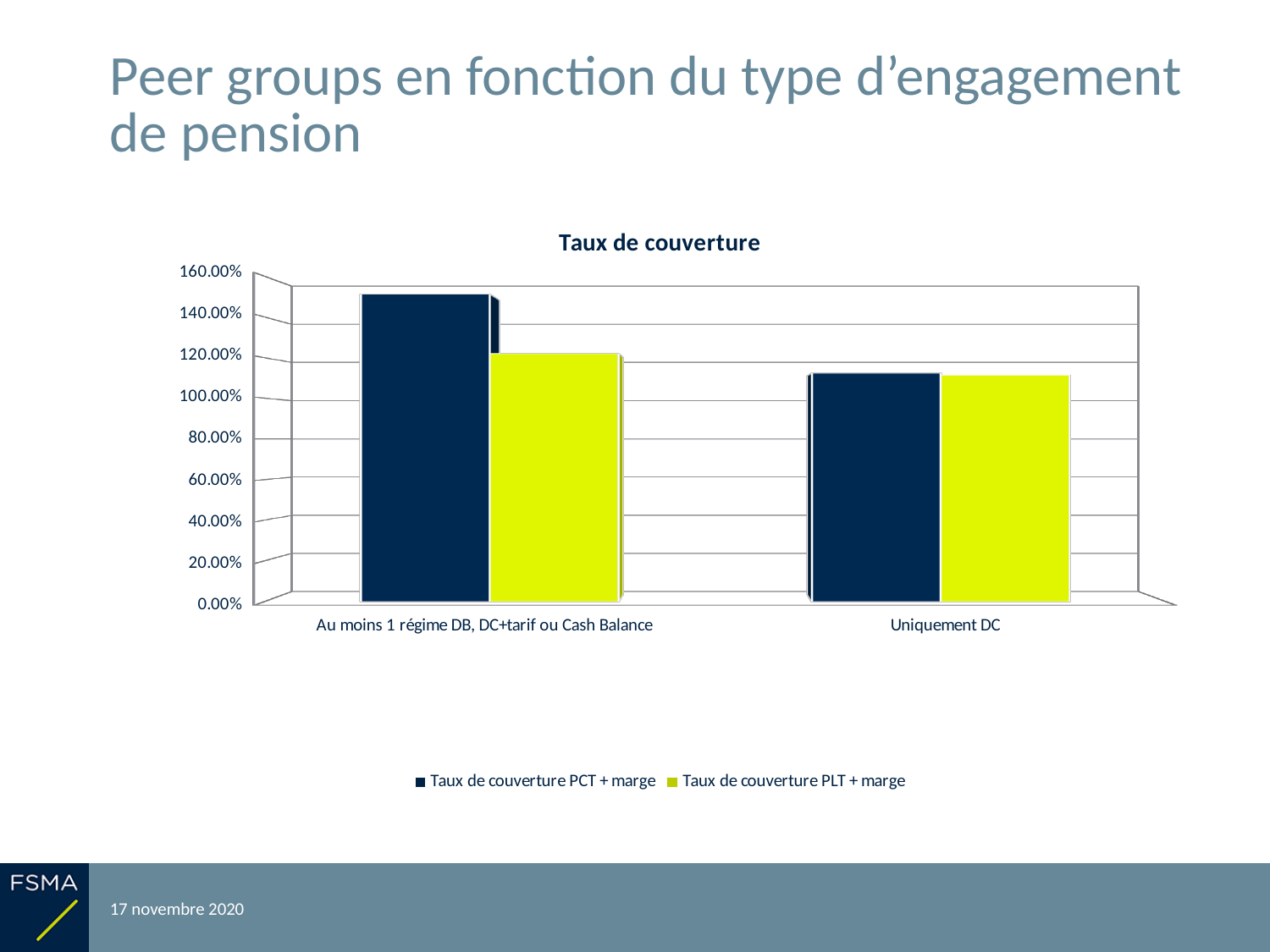
What is the title of the chart? Taux de couverture Is the value of Taux de couverture PLT + marge for 'Au moins 1 régime DB, DC+tarif ou Cash Balance' greater or less than 100.00%? greater Which series is shown in yellow-green? Taux de couverture PLT + marge How many series does the legend list? 2 What kind of chart is shown on the slide? bar chart Is the value of Taux de couverture PCT + marge for 'Uniquement DC' greater or less than 120.00%? less Which bar is the highest in the chart? Taux de couverture PCT + marge for Au moins 1 régime DB, DC+tarif ou Cash Balance How many categories are shown on the x axis? 2 Is the value of Taux de couverture PLT + marge for 'Uniquement DC' greater or less than 100.00%? greater For 'Au moins 1 régime DB, DC+tarif ou Cash Balance', which series has the larger value: Taux de couverture PCT + marge or Taux de couverture PLT + marge? Taux de couverture PCT + marge Does the Taux de couverture PCT + marge series rise or fall from 'Au moins 1 régime DB, DC+tarif ou Cash Balance' to 'Uniquement DC'? fall